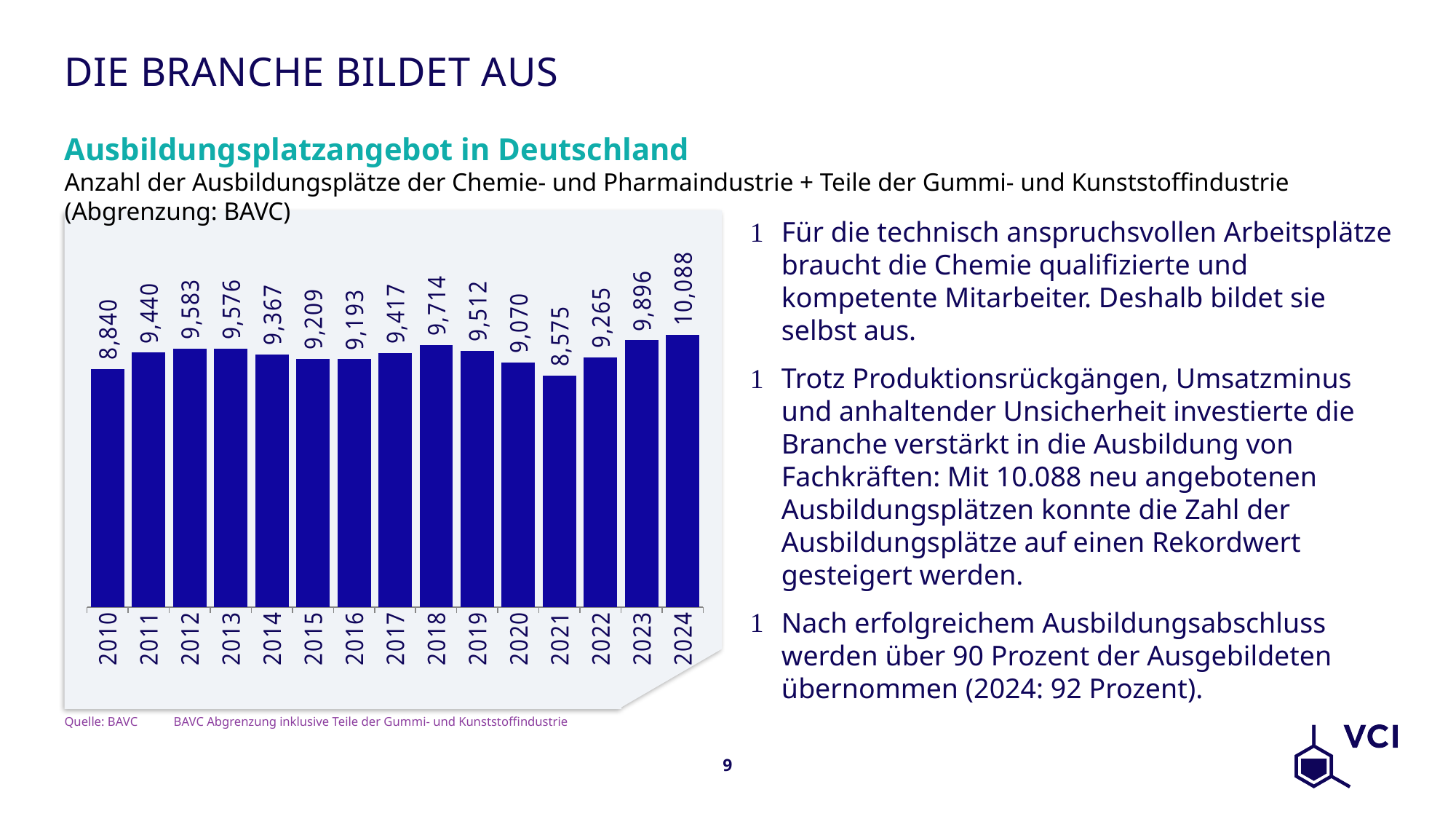
What is the difference between the values for 2024 and 2010? 1,248 What is the value for 2021? 8,575 Which year has the lowest value? 2021 What is the value for 2018? 9,714 What is the value for 2024? 10,088 What is the value for 2010? 8,840 Which is larger, the value for 2018 or the value for 2019? 2018 Do the values rise or fall from 2021 to 2024? Rise How many years are shown on the x axis? 15 What is the difference between the values for 2024 and 2023? 192 Which year has the highest value? 2024 What kind of chart is shown on the slide? Bar chart